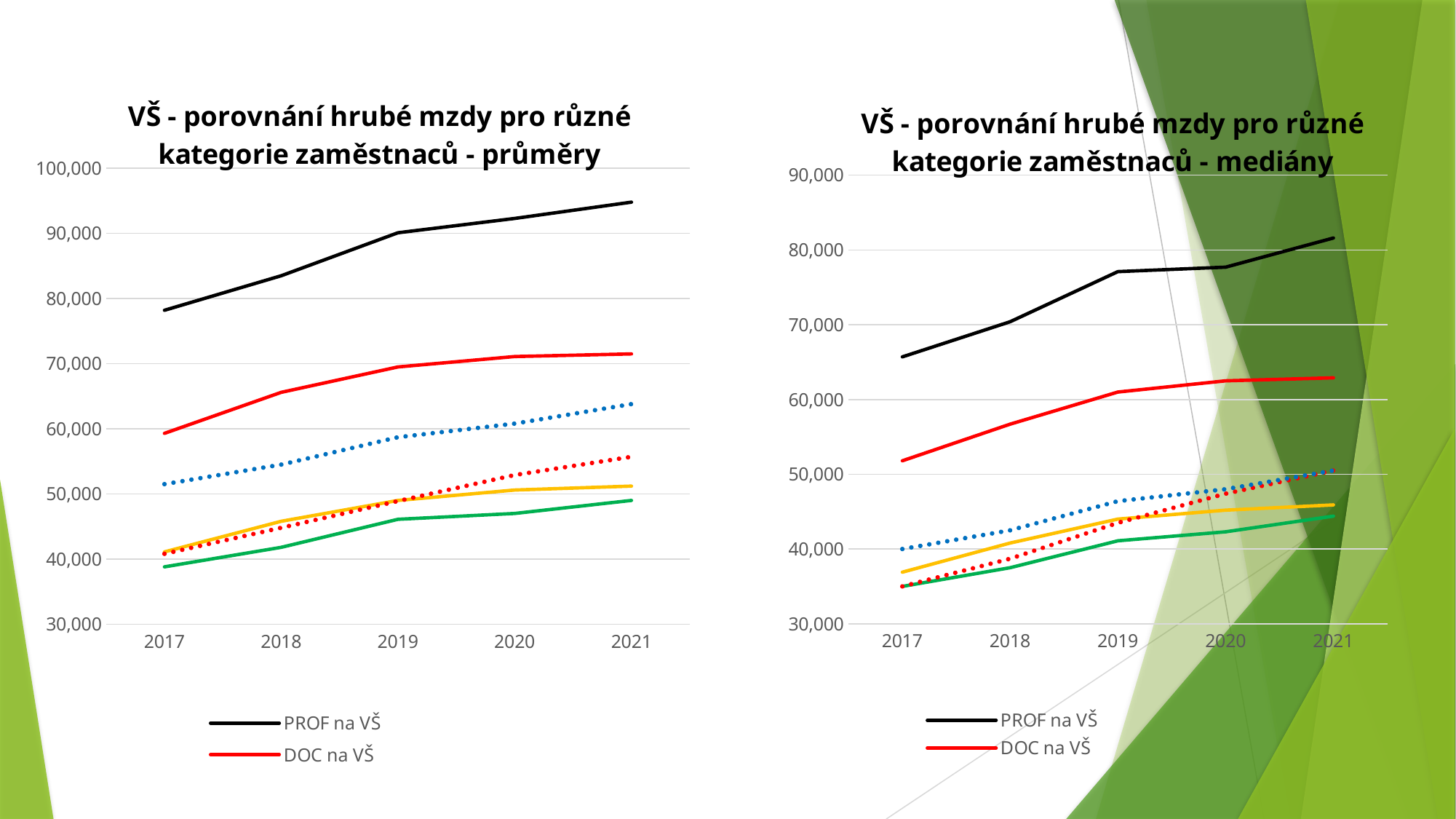
How many series does the legend of the left chart list? 2 In the left chart (průměry), does the PROF na VŠ line rise or fall from 2017 to 2021? rise In the right chart (mediány), which is larger in 2021: PROF na VŠ or DOC na VŠ? PROF na VŠ In the left chart (průměry), is the value for DOC na VŠ in 2021 greater or less than 70,000? greater In the right chart (mediány), is the value for DOC na VŠ in 2021 greater or less than 60,000? greater In the left chart (průměry), is the value for PROF na VŠ in 2021 greater or less than 90,000? greater What kind of chart is the left chart, 'VŠ - porovnání hrubé mzdy pro různé kategorie zaměstnaců - průměry'? line chart How many years are shown on the x axis of the right chart, 'VŠ - porovnání hrubé mzdy pro různé kategorie zaměstnaců - mediány'? 5 In the left chart (průměry), which legend series has the highest values across all years? PROF na VŠ